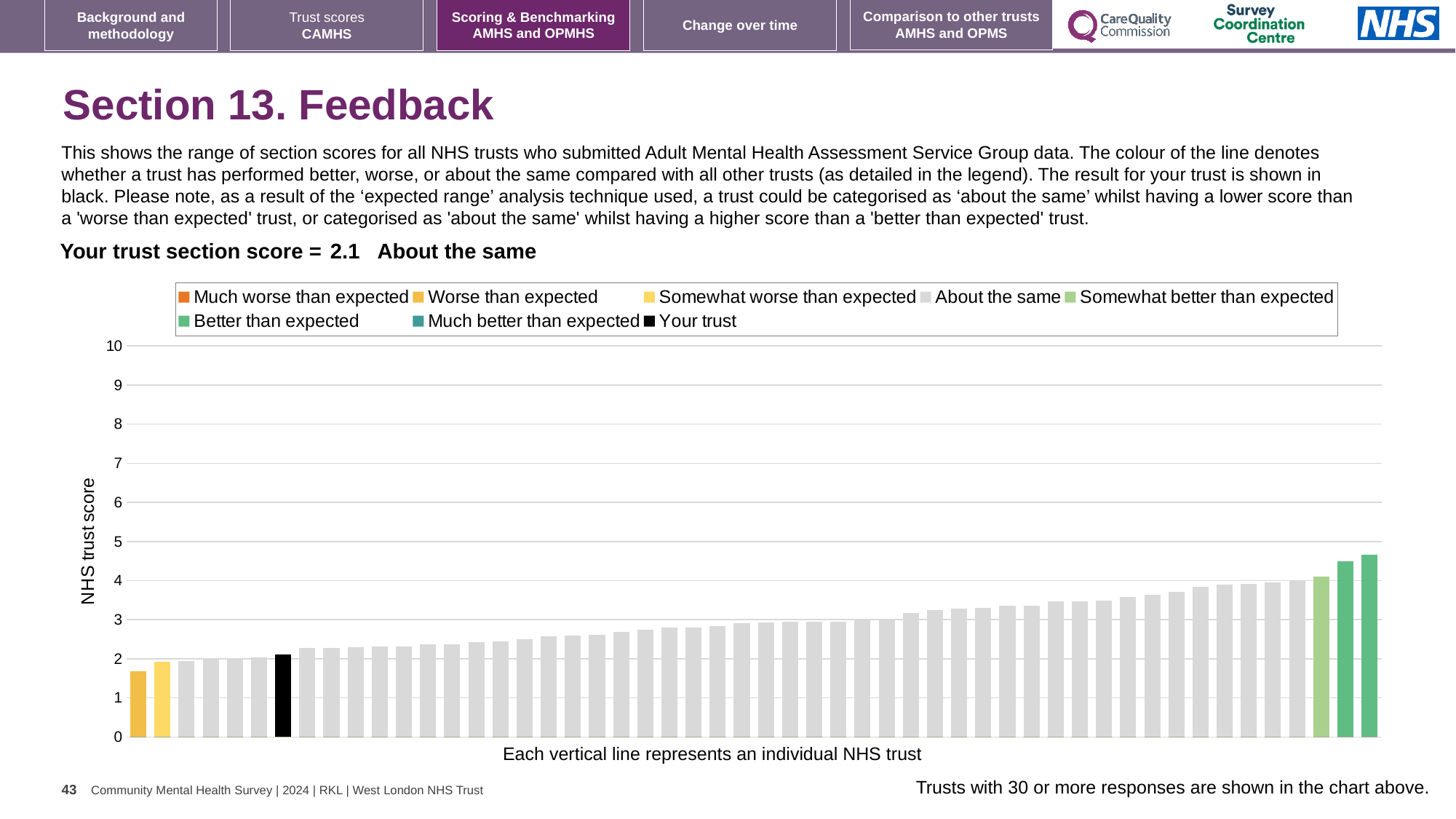
Is the value of the tallest bar greater or less than 4? greater Is the value of the leftmost bar greater or less than 2? less Is the value of the black 'Your trust' bar greater or less than 3? less Do the bar values rise or fall from left to right along the x axis? rise What is the label on the vertical axis of the chart? NHS trust score How many entries does the chart legend list? 8 What is the section score for your trust? 2.1 What kind of chart is shown on the slide? bar chart Which is larger: the value of the 'Your trust' bar or the value of the leftmost bar? Your trust Which legend category does the tallest bar belong to? Better than expected What colour is the bar representing your trust? black